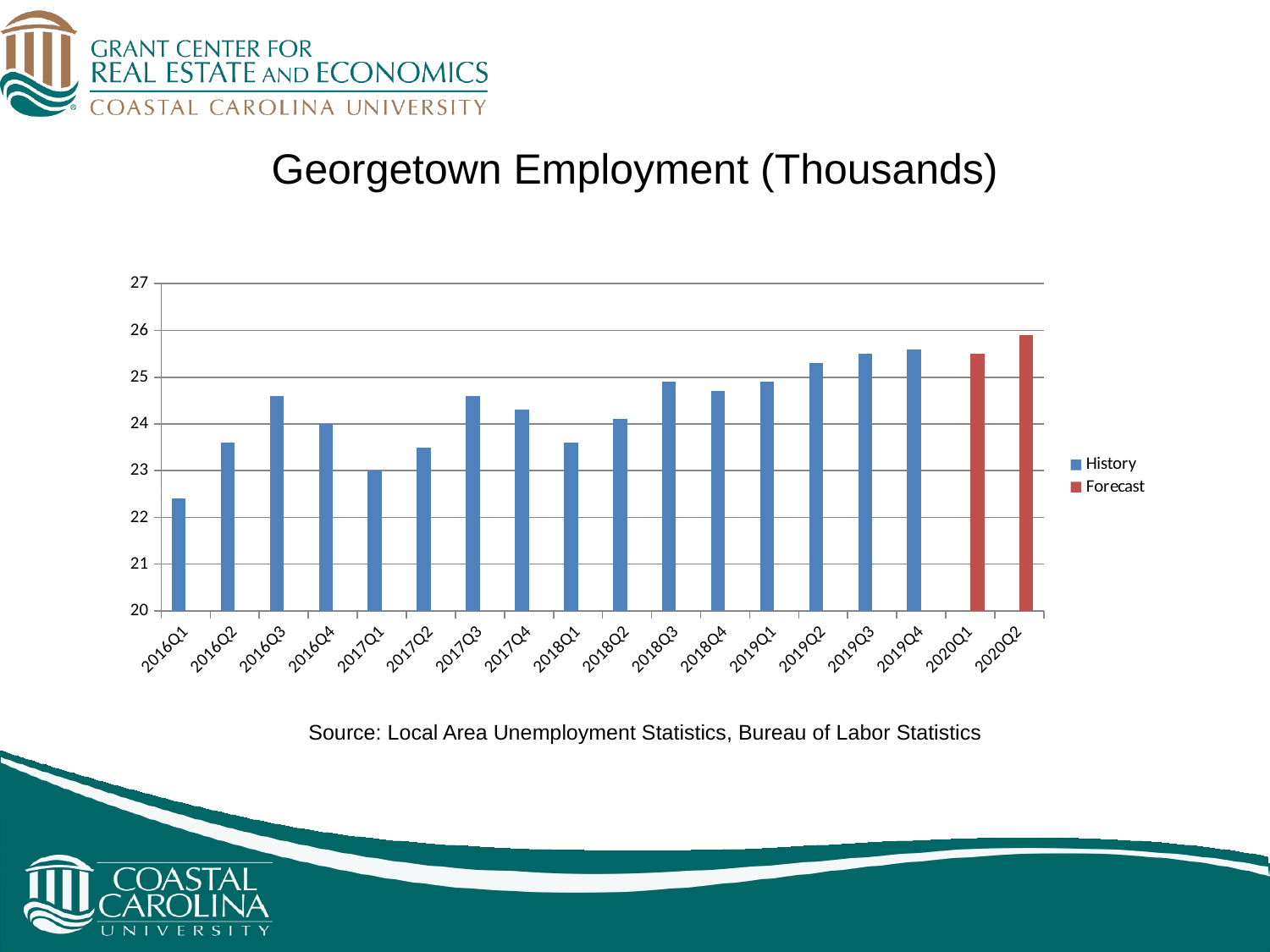
Is the value for 2020Q2 greater or less than 25? greater Which is larger, the value for 2016Q1 or the value for 2019Q4? 2019Q4 Overall, do the employment values rise or fall from 2016Q1 to 2020Q2? rise What kind of chart is shown on the slide? bar chart Is the value for 2019Q3 greater or less than 25? greater Is the value for 2018Q1 greater or less than 24? less Which quarter has the highest employment value? 2020Q2 How many quarters are shown on the x axis? 18 What are the two series named in the legend? History and Forecast How many series does the legend list? 2 Which quarter has the lowest employment value? 2016Q1